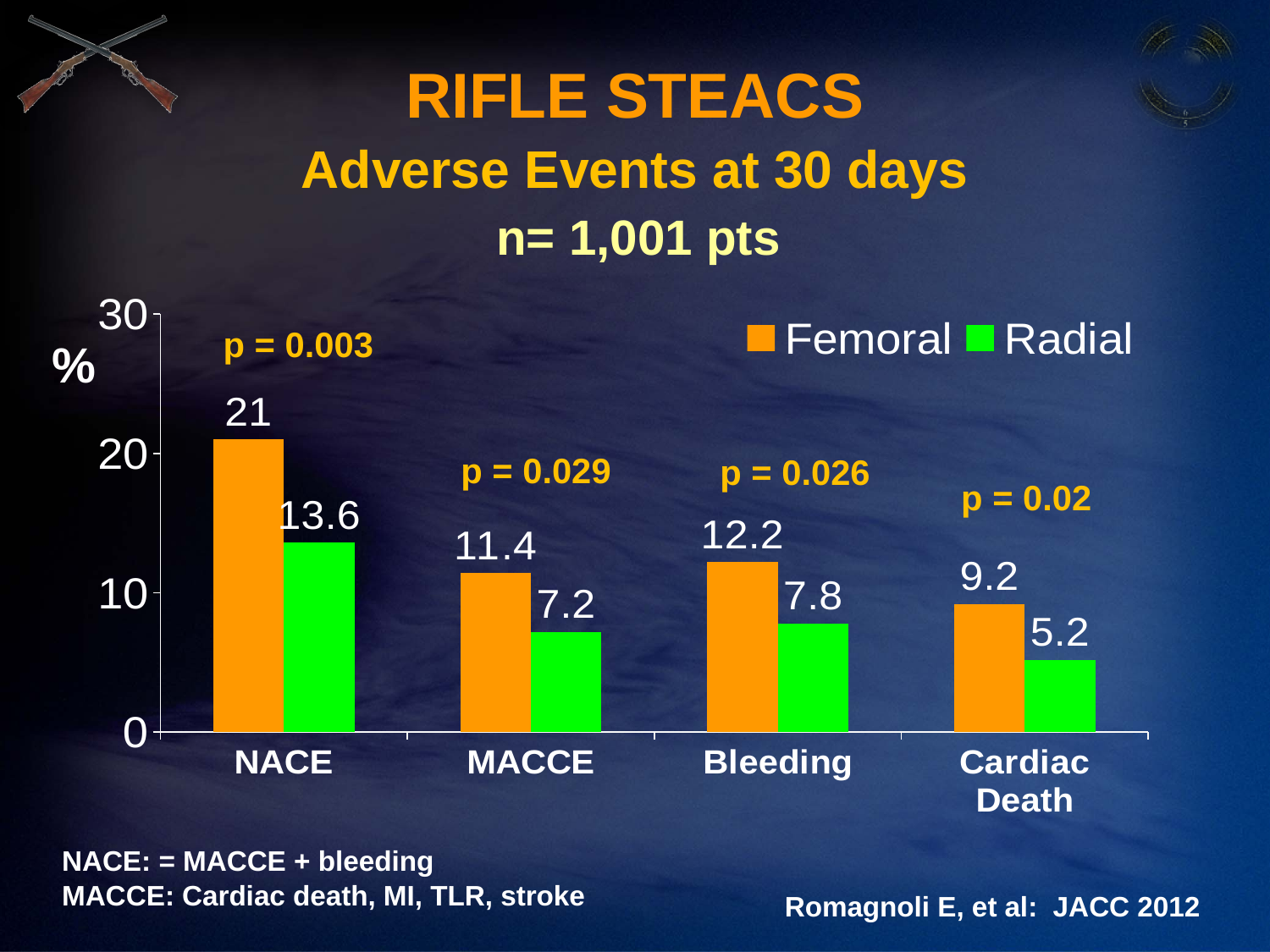
Which category has the highest Femoral value? NACE How many categories are shown on the x axis? 4 Which category has the lowest Radial value? Cardiac Death What is the Femoral value for NACE? 21 What is the Radial value for Bleeding? 7.8 What is the Femoral value for MACCE? 11.4 How many series does the legend list? 2 What kind of chart is shown on the slide? Bar chart What is the Radial value for Cardiac Death? 5.2 What is the difference between the Femoral and Radial values for NACE? 7.4 Which is larger for Bleeding, the Femoral value or the Radial value? Femoral What p-value is shown above the MACCE bars? p = 0.029